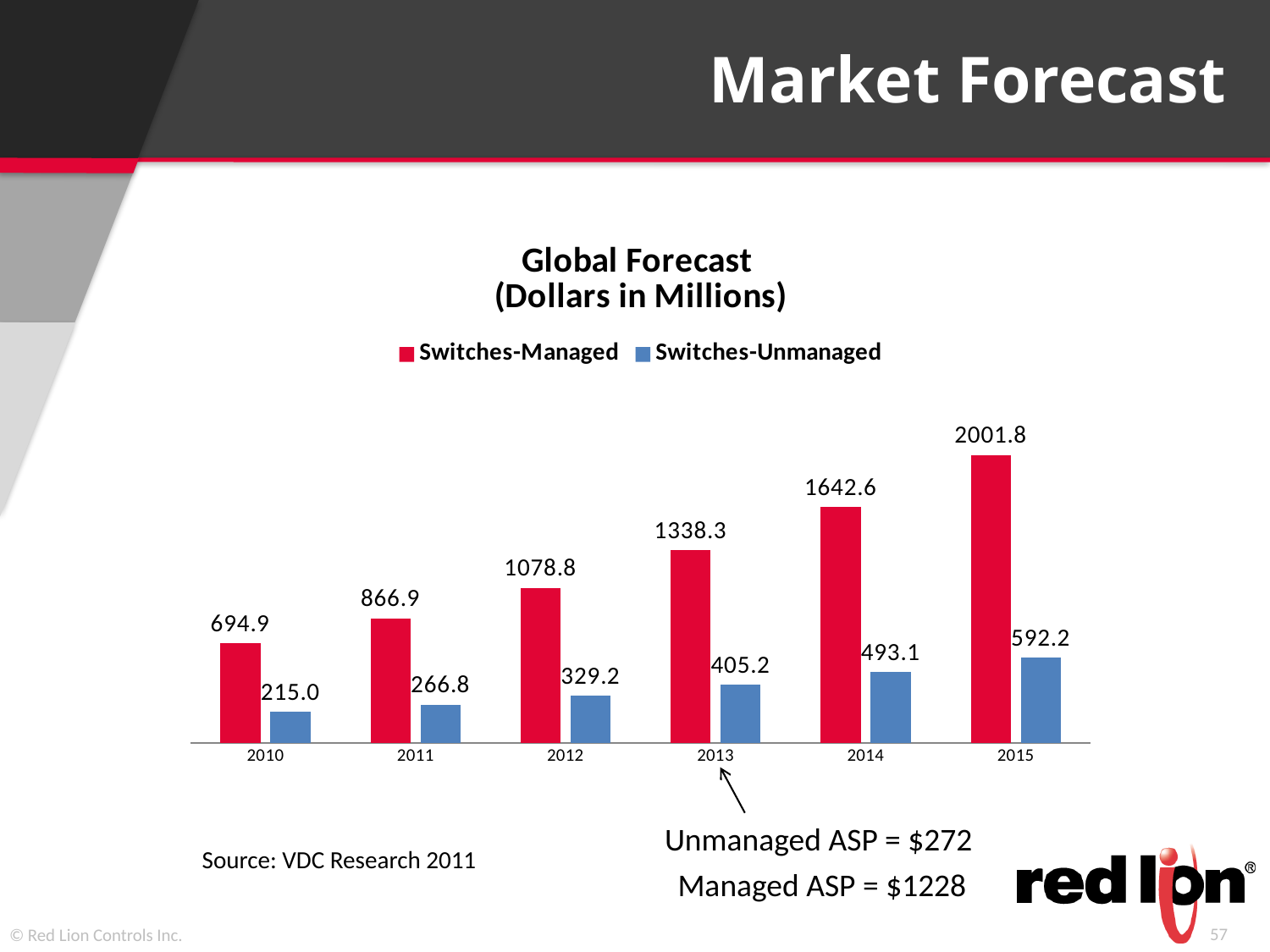
What kind of chart is shown? Bar chart What is the Switches-Managed value for 2013? 1338.3 What is the difference between the Switches-Managed and Switches-Unmanaged values in 2015? 1409.6 Do the Switches-Managed values rise or fall from 2010 to 2015? Rise Which year has the lowest Switches-Unmanaged value? 2010 What colour represents Switches-Unmanaged in the chart? Blue What is the title of the chart? Global Forecast (Dollars in Millions) Which year has the highest Switches-Managed value? 2015 What is the Switches-Unmanaged value for 2011? 266.8 Which is larger in 2012: Switches-Managed or Switches-Unmanaged? Switches-Managed How many years are shown on the x axis? 6 How many series does the legend list? 2